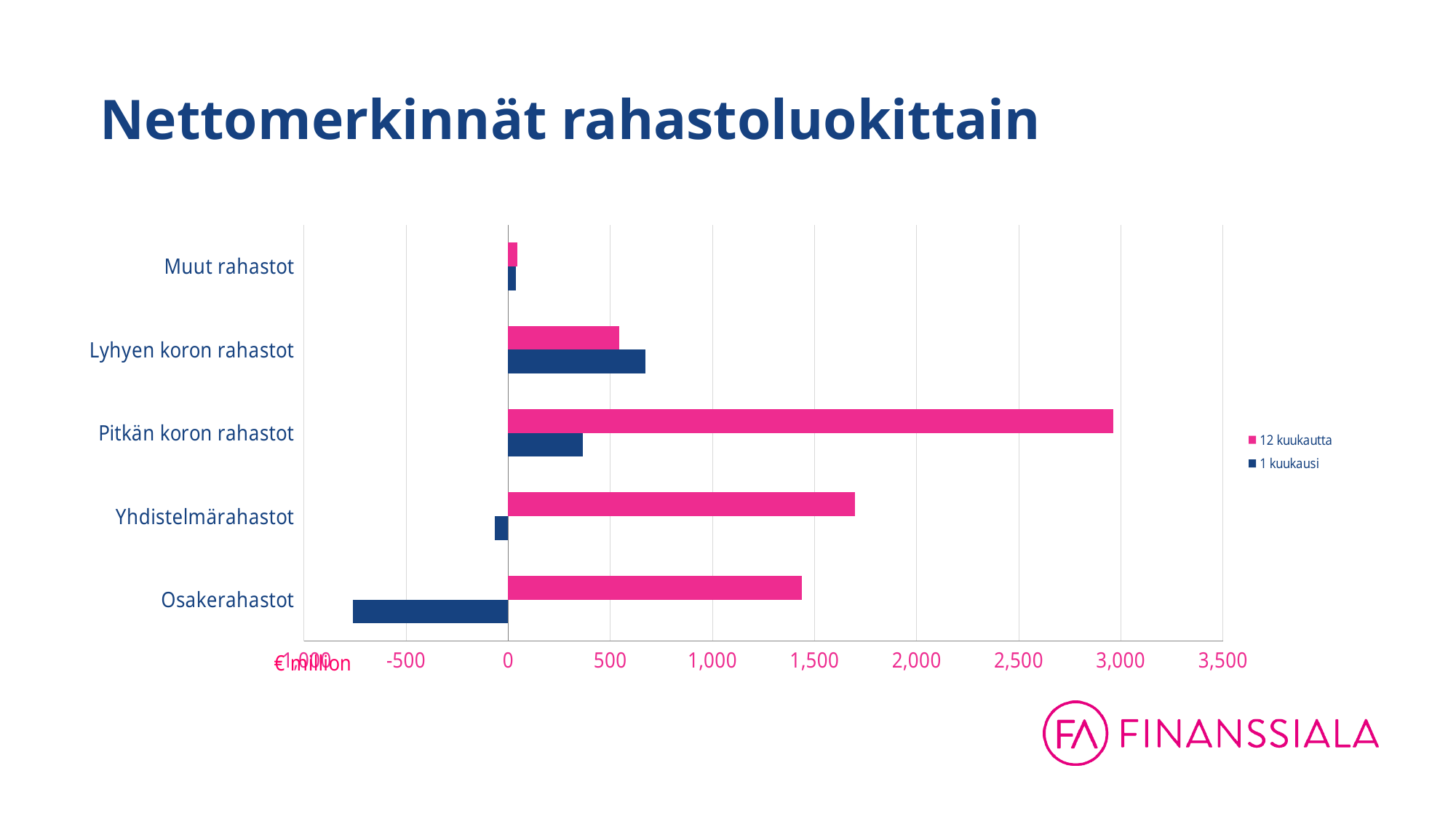
How many series does the legend list? 2 Is the 1 kuukausi value for Osakerahastot greater or less than -500? less Is the 12 kuukautta value for Yhdistelmärahastot greater or less than 1,500? greater What kind of chart is shown on the slide? bar chart Is the 12 kuukautta value for Pitkän koron rahastot greater or less than 2,500? greater Which category has the highest value for the 12 kuukautta series? Pitkän koron rahastot Which category has the lowest value for the 1 kuukausi series? Osakerahastot Which category has the highest value for the 1 kuukausi series? Lyhyen koron rahastot What is the title of the chart? Nettomerkinnät rahastoluokittain For Lyhyen koron rahastot, which series has the larger value, 12 kuukautta or 1 kuukausi? 1 kuukausi How many fund categories are shown on the chart? 5 Which is larger for the 12 kuukautta series: Yhdistelmärahastot or Osakerahastot? Yhdistelmärahastot